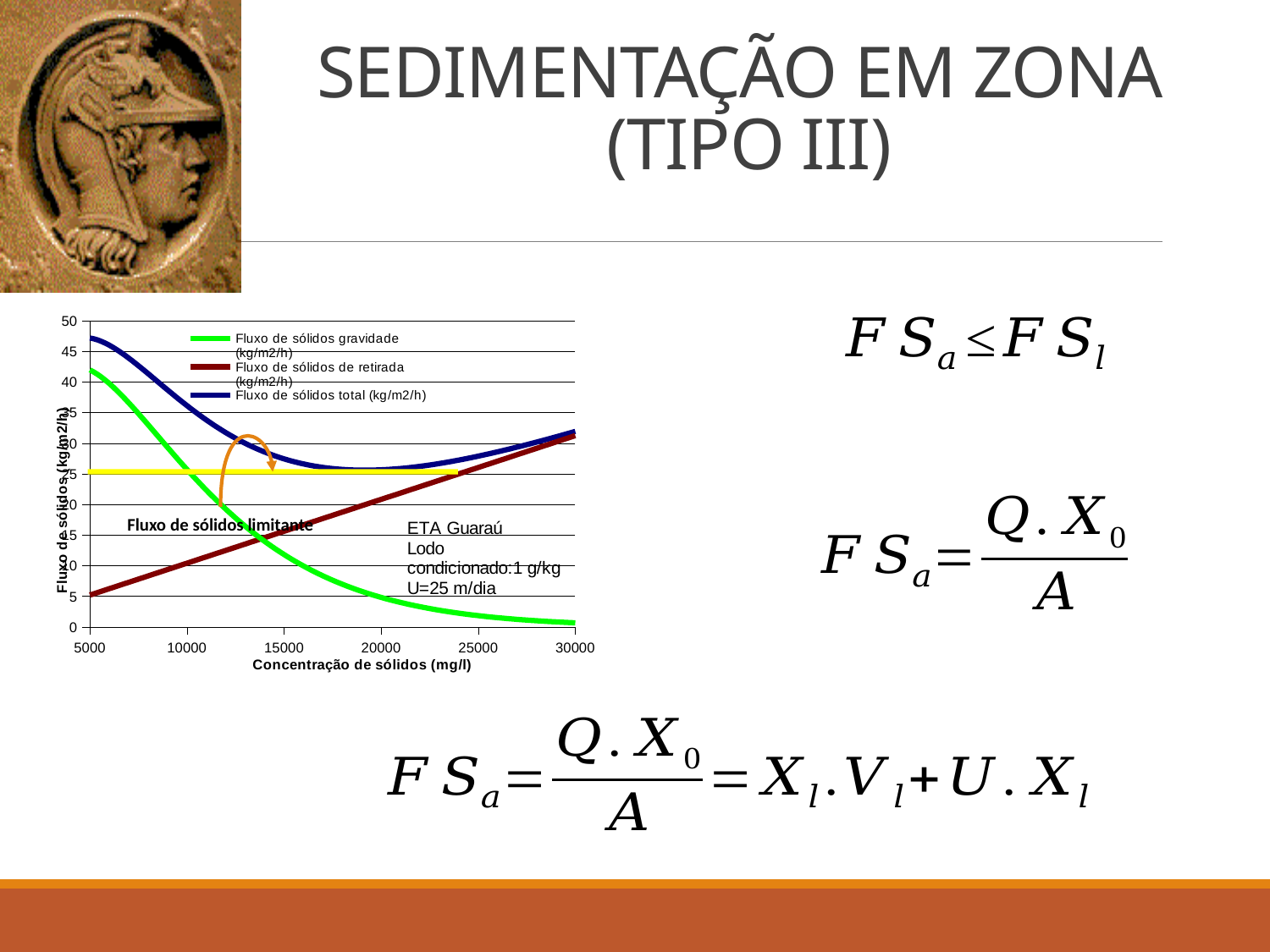
At a concentration of 5000, which series has the larger value: 'Fluxo de sólidos total' or 'Fluxo de sólidos gravidade'? Fluxo de sólidos total What kind of chart is shown on the slide? line chart Which series is drawn in green in the chart? Fluxo de sólidos gravidade (kg/m2/h) Is the value of 'Fluxo de sólidos gravidade' at a concentration of 5000 greater or less than 40? greater Does the 'Fluxo de sólidos de retirada' series rise or fall as the concentration increases from 5000 to 30000? rise At a concentration of 30000, which series has the larger value: 'Fluxo de sólidos de retirada' or 'Fluxo de sólidos gravidade'? Fluxo de sólidos de retirada How many series does the chart legend list? 3 What is the title of the x axis of the chart? Concentração de sólidos (mg/l) Is the value of 'Fluxo de sólidos de retirada' at a concentration of 30000 greater or less than 30? greater Is the value of 'Fluxo de sólidos gravidade' at a concentration of 30000 greater or less than 5? less Does the 'Fluxo de sólidos gravidade' series rise or fall as the concentration increases from 5000 to 30000? fall